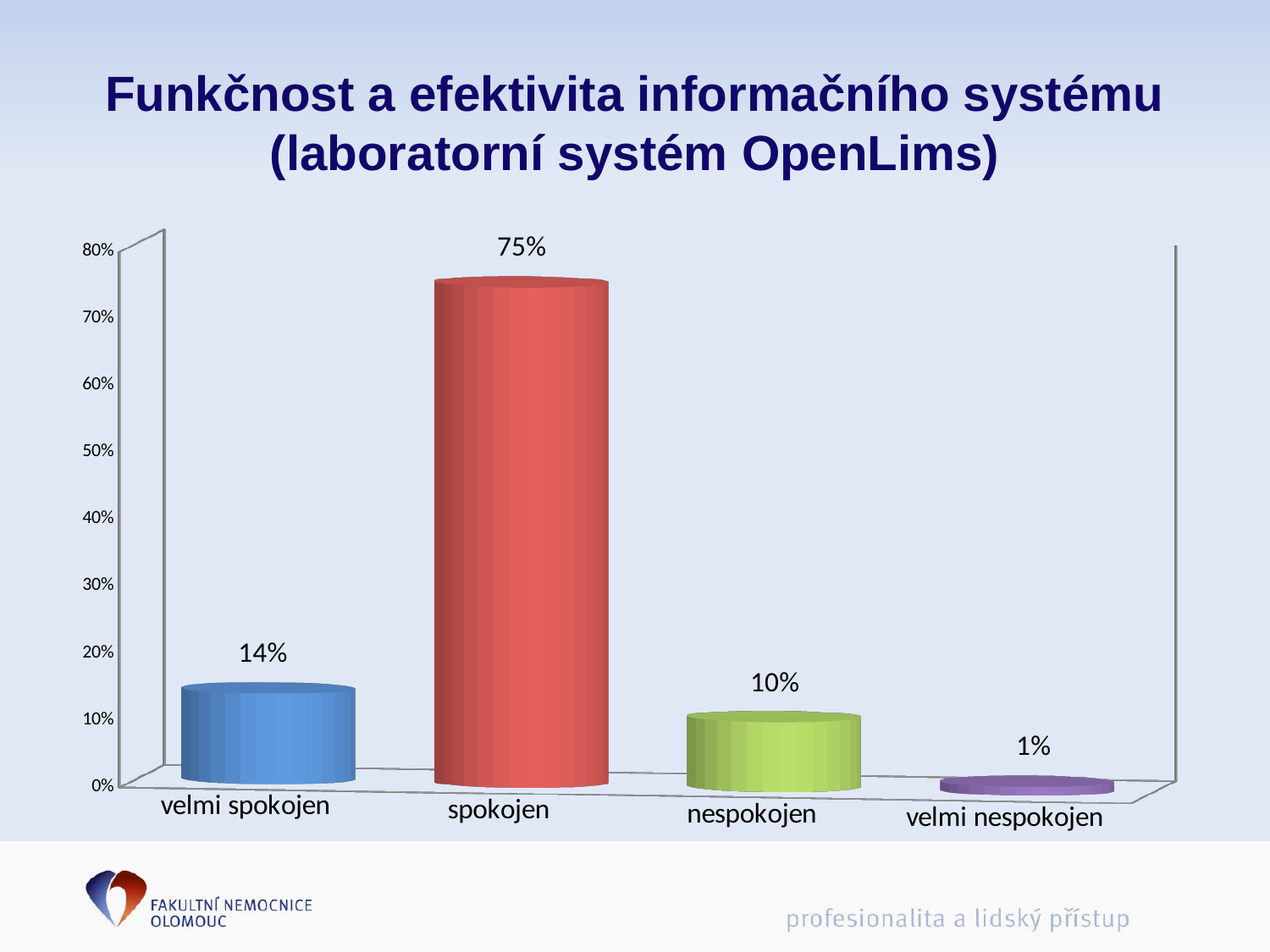
Which category has the highest value? spokojen Which category has the lowest value? velmi nespokojen What is the difference between the values for "spokojen" and "velmi spokojen"? 61% What is the value for "nespokojen"? 10% What colour is the bar for "spokojen"? red What kind of chart is shown on the slide? bar chart What is the value for "velmi spokojen"? 14% What is the value for "velmi nespokojen"? 1% Is the value for "spokojen" greater or less than 70%? greater Which is larger, the value for "velmi spokojen" or the value for "nespokojen"? velmi spokojen What is the value for "spokojen"? 75% How many categories are shown on the x axis? 4